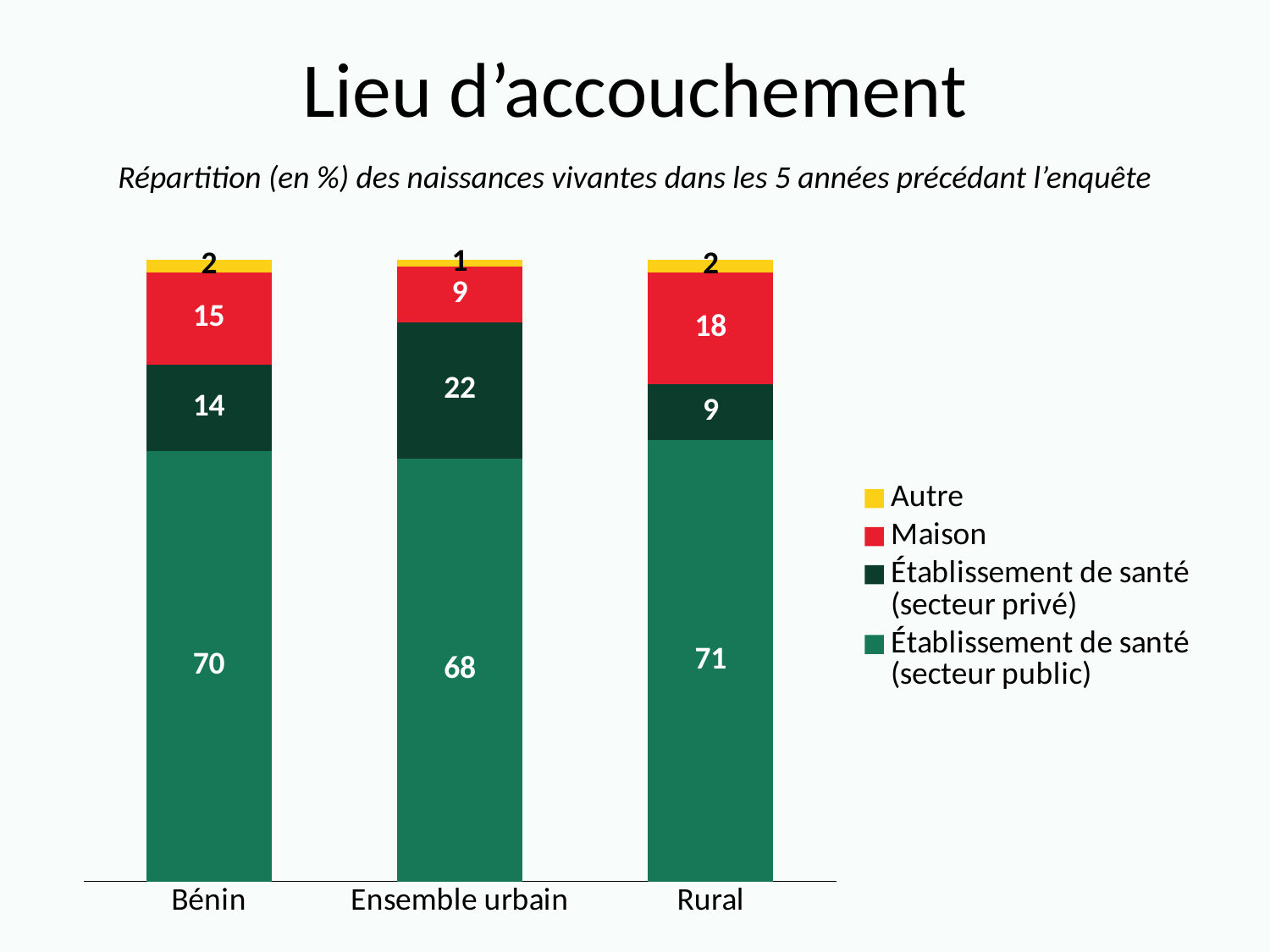
What is the value for Établissement de santé (secteur privé) for Ensemble urbain? 22 What is the value for Établissement de santé (secteur public) for Bénin? 70 What is the value for Autre for Ensemble urbain? 1 Is the Établissement de santé (secteur public) value larger for Rural or for Ensemble urbain? Rural What is the value for Maison for Rural? 18 How many series does the legend list? 4 Which category has the lowest value for Maison? Ensemble urbain What is the difference between the Maison values for Rural and Ensemble urbain? 9 What kind of chart is shown? Stacked bar chart What is the total of the stacked bar for Bénin? 101 Which category has the highest value for Établissement de santé (secteur privé)? Ensemble urbain How many categories are shown on the x axis? 3